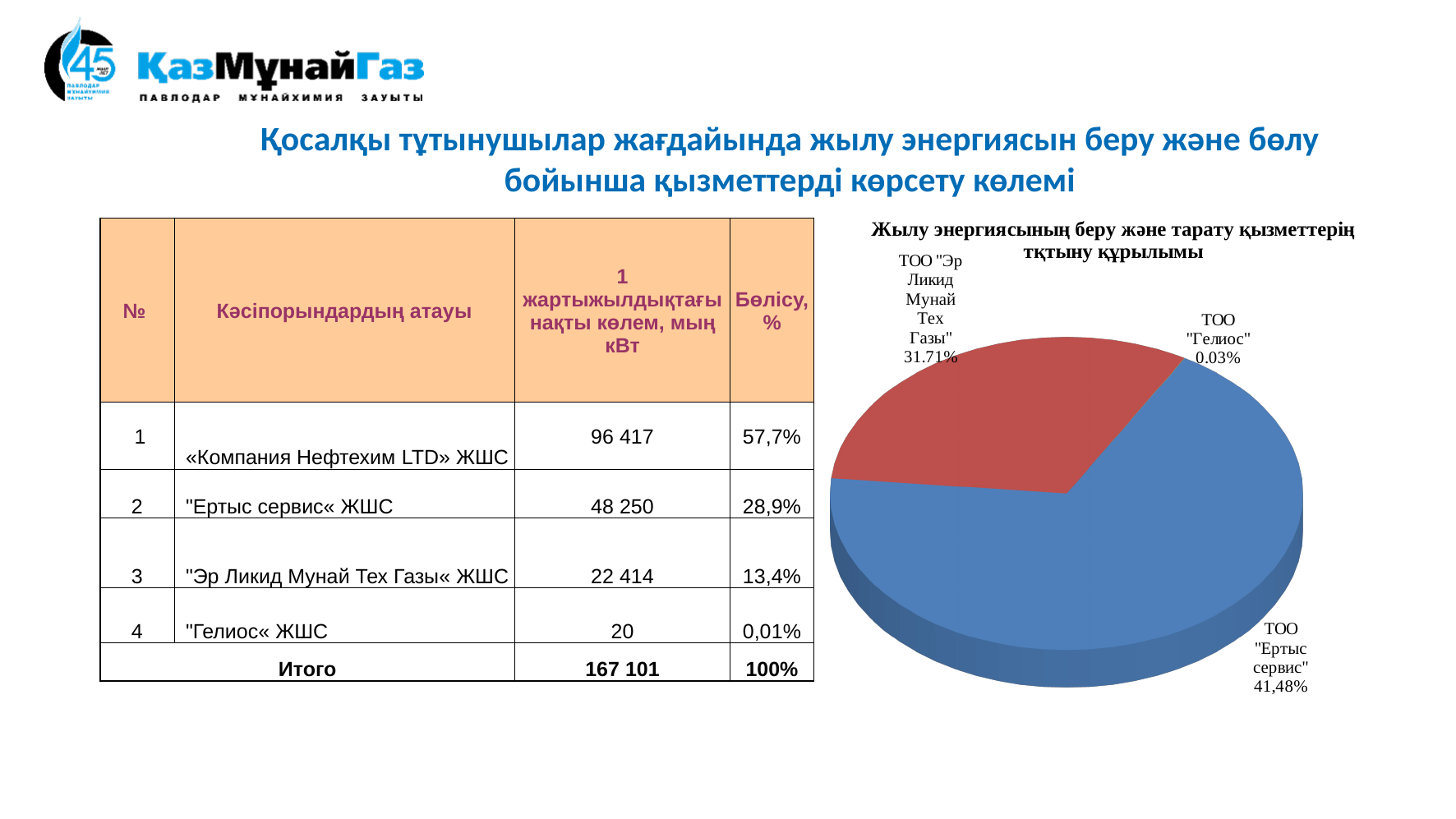
Which company has the largest slice in the pie chart? ТОО "Ертыс сервис" How many companies are labelled in the pie chart? 3 In the pie chart, which slice is larger: ТОО "Ертыс сервис" or ТОО "Эр Ликид Мунай Тех Газы"? ТОО "Ертыс сервис" What colour is the slice for ТОО "Ертыс сервис" in the pie chart? Blue What share of the pie chart is labelled for ТОО "Гелиос"? 0.03% What share of the pie chart is labelled for ТОО "Ертыс сервис"? 41,48% What type of chart is shown on the slide? Pie chart What is the title of the pie chart? Жылу энергиясының беру және тарату қызметтерің тқтыну құрылымы Which company has the smallest slice in the pie chart? ТОО "Гелиос" What share of the pie chart is labelled for ТОО "Эр Ликид Мунай Тех Газы"? 31.71%